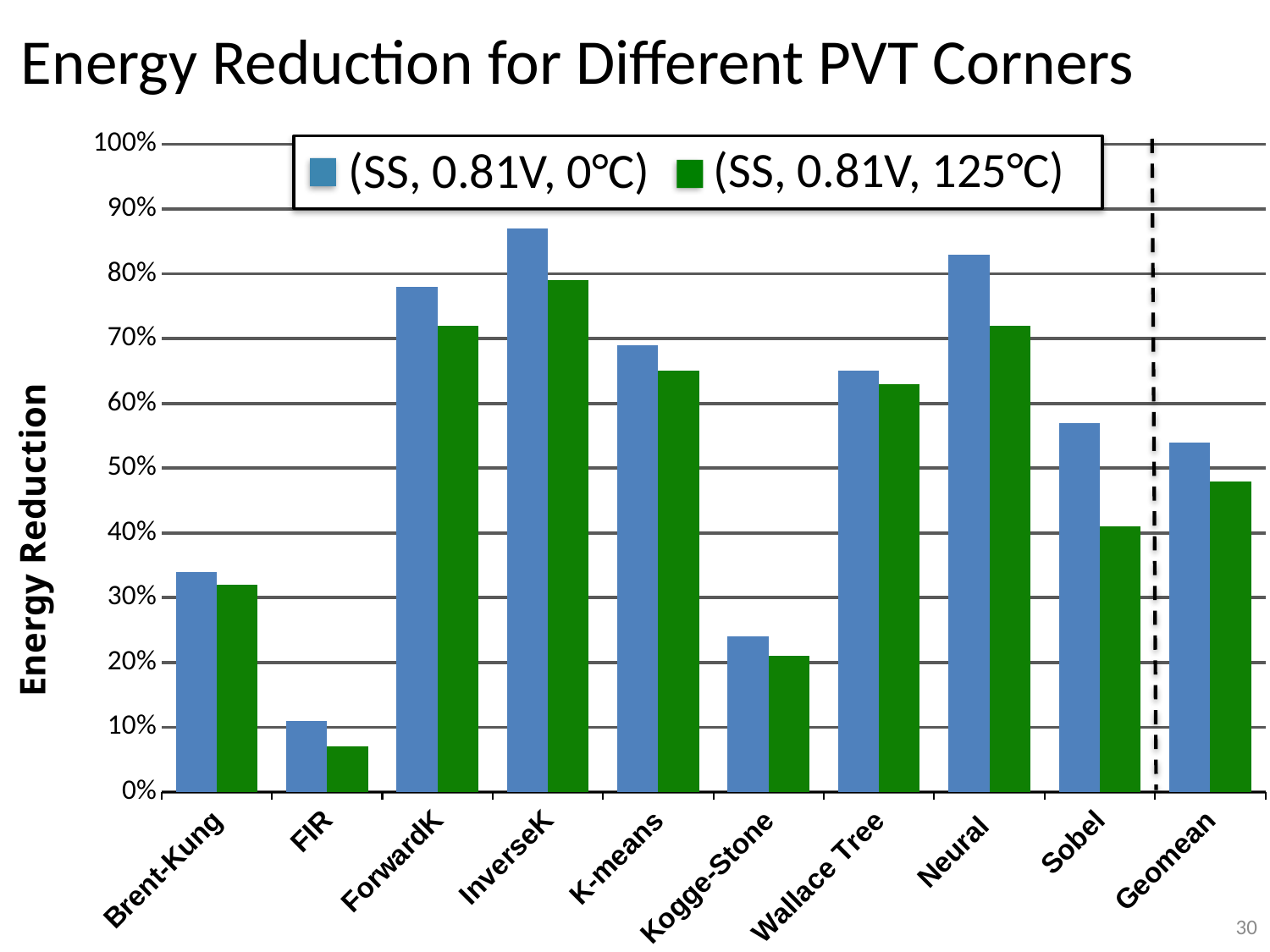
Is the (SS, 0.81V, 0°C) value for Kogge-Stone greater or less than 20%? greater What is the label of the y axis? Energy Reduction Is the (SS, 0.81V, 0°C) value for Brent-Kung greater or less than 30%? greater What kind of chart is shown on the slide? bar chart Which category has the highest energy reduction for the (SS, 0.81V, 0°C) series? InverseK Is the (SS, 0.81V, 125°C) value for Geomean greater or less than 50%? less Which is larger for the (SS, 0.81V, 125°C) series: InverseK or ForwardK? InverseK How many categories are shown on the x axis? 10 Which is larger for the (SS, 0.81V, 0°C) series: Neural or Sobel? Neural Which category has the lowest energy reduction for the (SS, 0.81V, 125°C) series? FIR How many series does the legend list? 2